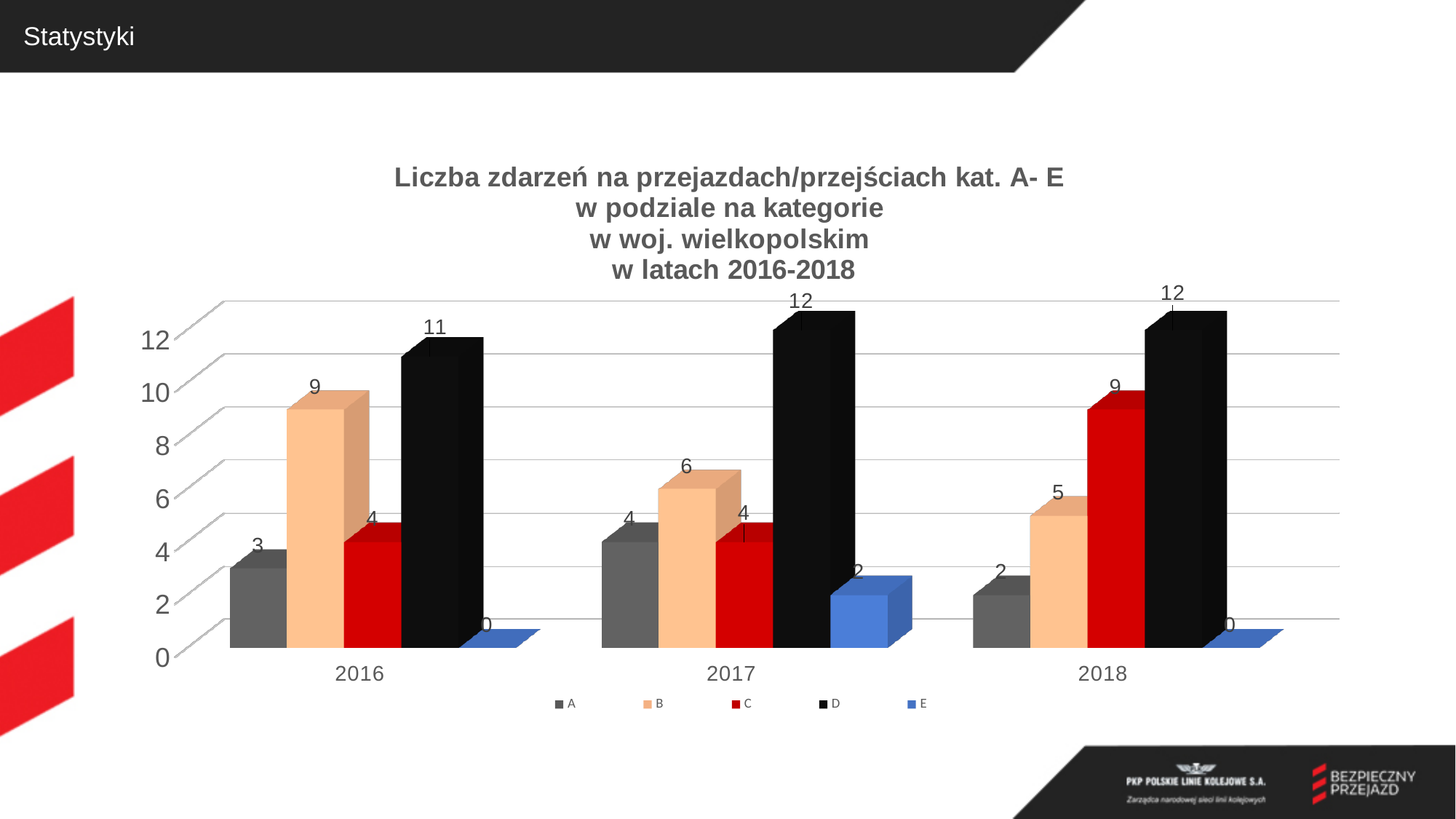
What is the value for series C in 2018? 9 What is the value for series B in 2017? 6 Which is larger in 2017: series A or series B? B Which series has the lowest value in 2016? E Does the value for series B rise or fall from 2016 to 2018? Fall What is the value for series D in 2016? 11 What kind of chart is shown on the slide? Bar chart How many series does the legend list? 5 What is the difference between series D and series B in 2016? 2 How many years are shown on the x axis? 3 Which series has the highest value in 2018? D What is the value for series E in 2017? 2